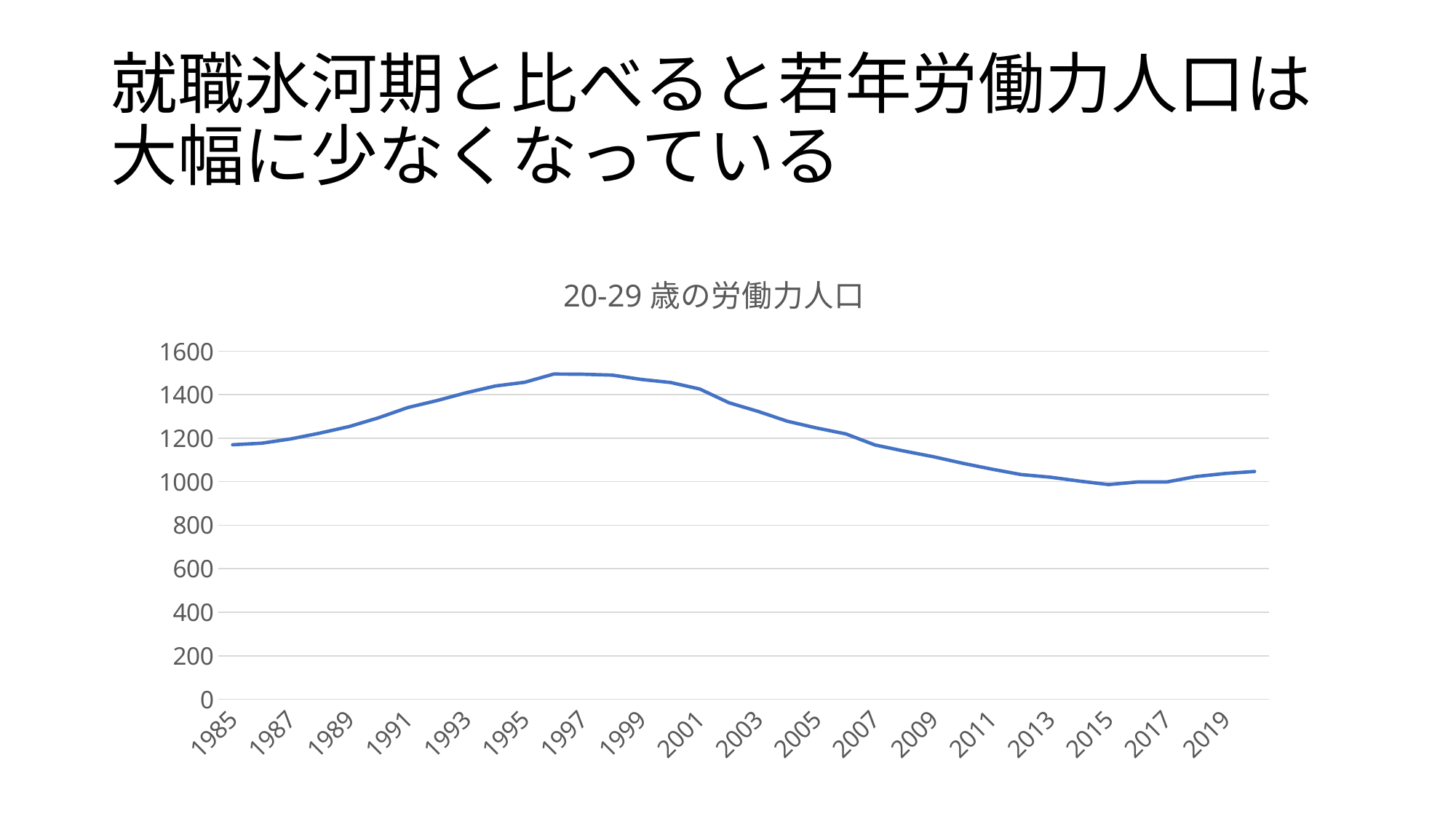
Is the value for 1997 greater or less than 1400? greater What is the title of the chart? 20-29 歳の労働力人口 Is the value for 1991 greater or less than 1200? greater Is the value for 1985 greater or less than 1000? greater Does the line rise or fall between 1997 and 2015? fall What is the highest value shown on the vertical axis of the chart? 1600 Which is larger, the value for 1985 or the value for 2019? 1985 What kind of chart is shown on the slide? line chart Which is larger, the value for 1997 or the value for 2007? 1997